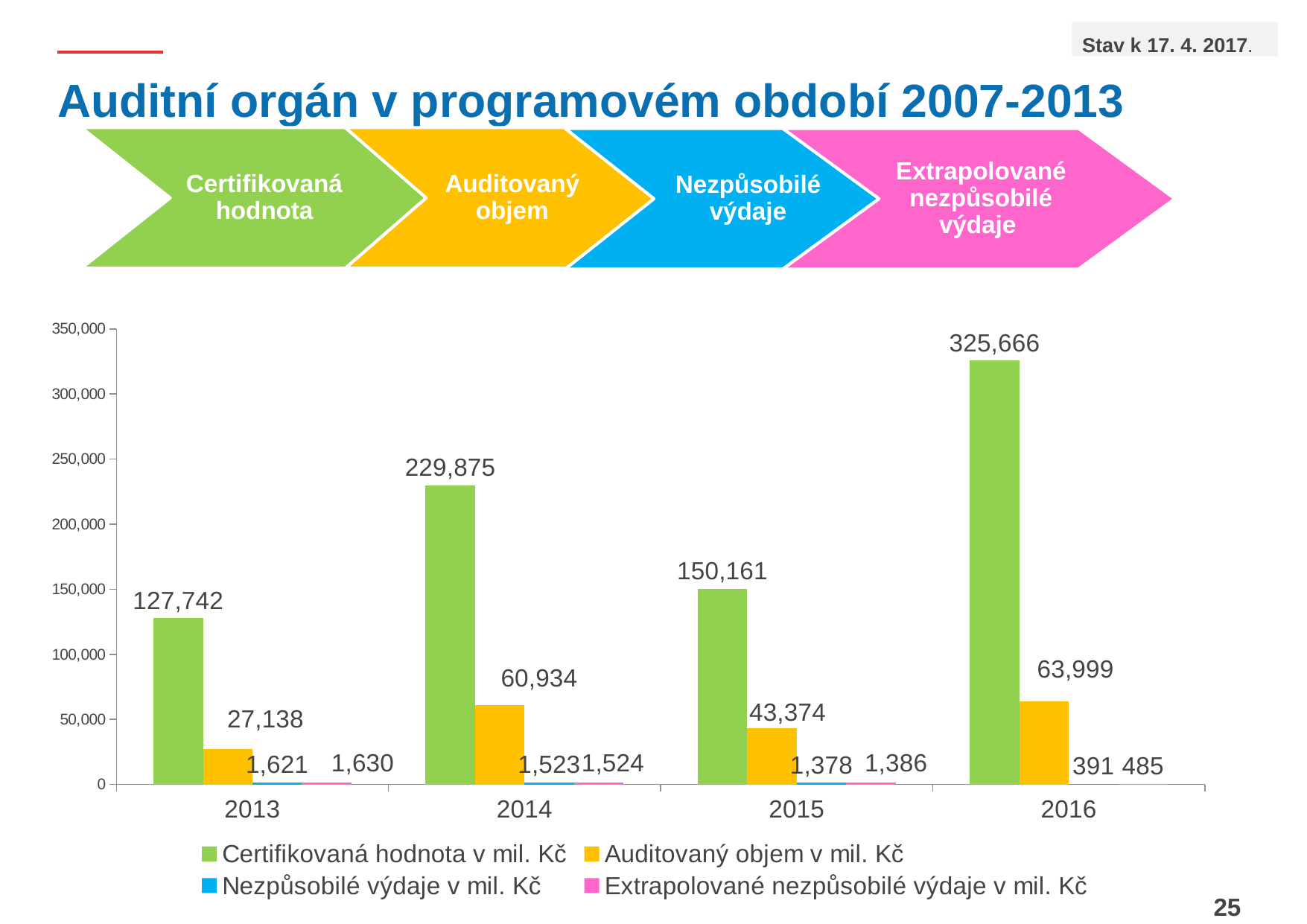
What is the value of Extrapolované nezpůsobilé výdaje v mil. Kč for 2015? 1,386 How many series does the legend list? 4 In which year is Auditovaný objem v mil. Kč the lowest? 2013 What is the value of Auditovaný objem v mil. Kč for 2014? 60,934 What is the value of Nezpůsobilé výdaje v mil. Kč for 2013? 1,621 What kind of chart is shown on the slide? Bar chart What is the difference between Certifikovaná hodnota v mil. Kč in 2014 and in 2013? 102,133 Which is larger: Auditovaný objem v mil. Kč in 2015 or in 2016? 2016 Which colour represents Nezpůsobilé výdaje v mil. Kč in the legend? Blue What is the value of Certifikovaná hodnota v mil. Kč for 2016? 325,666 How many years are shown on the x axis? 4 In which year is Certifikovaná hodnota v mil. Kč the highest? 2016